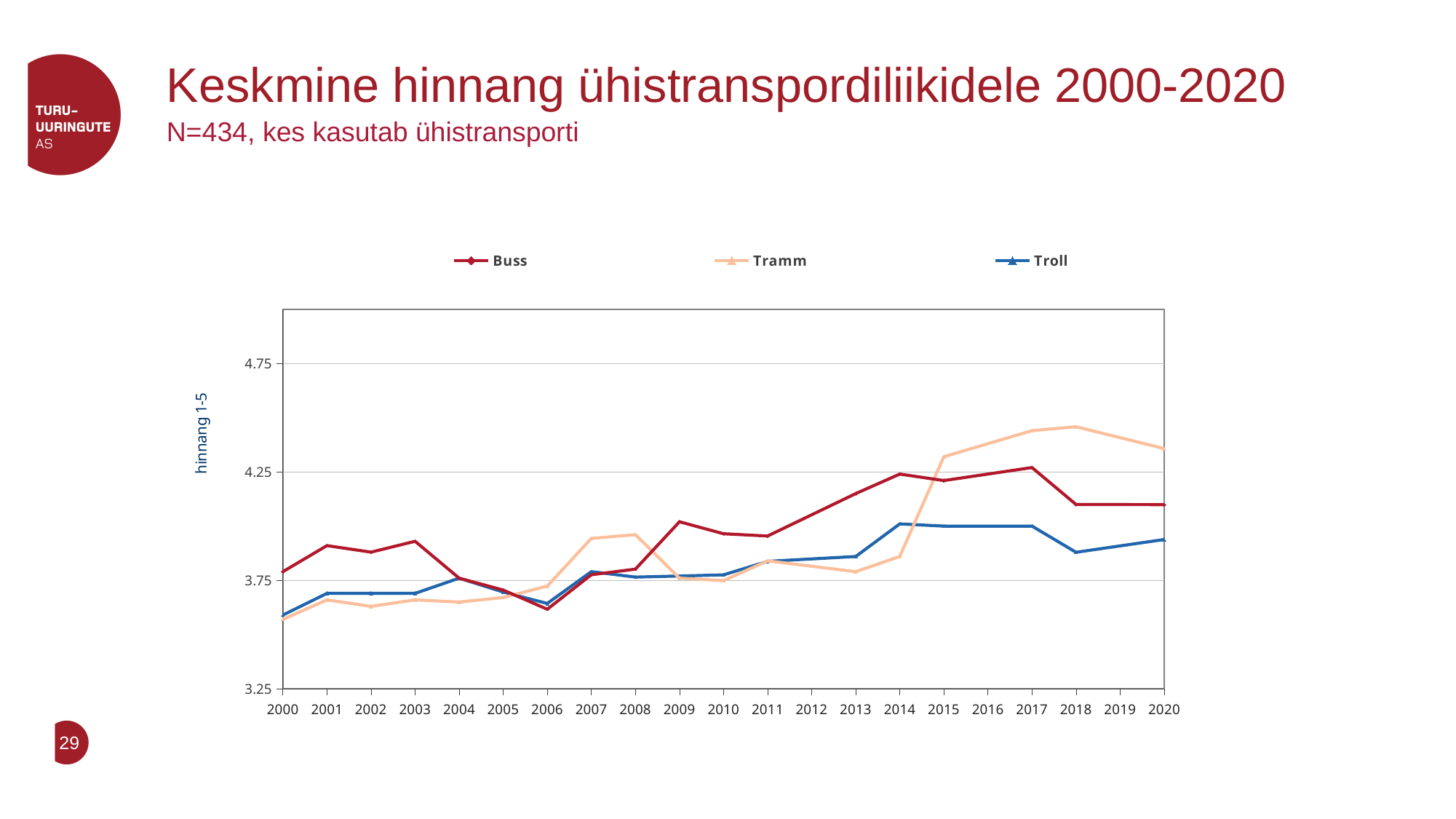
Is the value for Tramm in 2018 greater or less than 4.25? greater Is the value for Buss in 2006 greater or less than 3.75? less In 2009, which is higher: Buss or Tramm? Buss What kind of chart is shown on the slide? line chart How many years are plotted along the x axis? 21 Which series has the highest value in 2018? Tramm Does the Tramm line rise or fall from 2014 to 2018? rise How many series does the legend list? 3 Which series has the lowest value in 2020? Troll What is the label on the y axis? hinnang 1-5 Is the value for Troll in 2020 greater or less than 4.25? less In 2020, which is higher: Tramm or Buss? Tramm